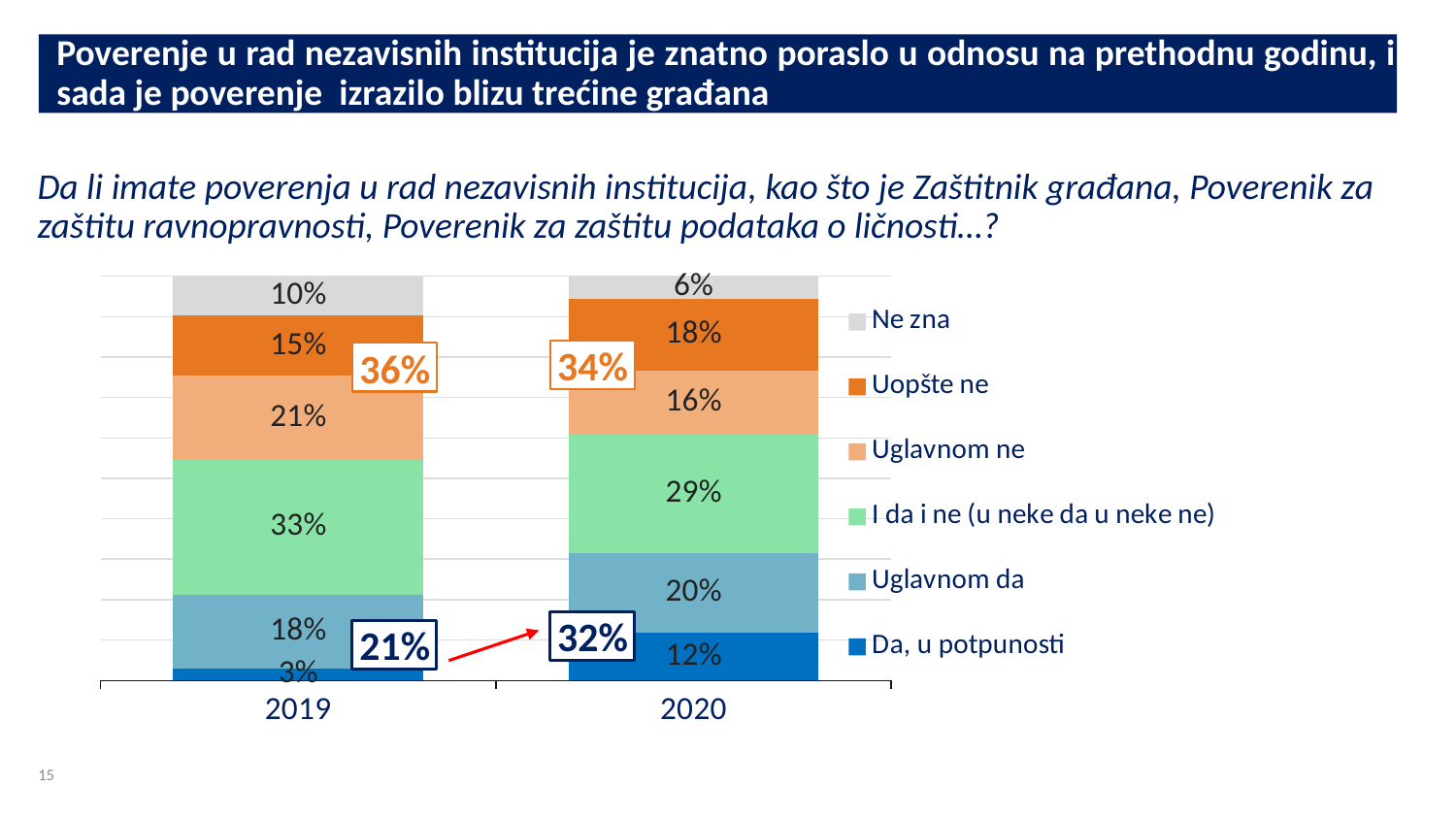
How many years (categories) are shown on the x axis? 2 What is the value for "Ne zna" in 2020? 6% What is the difference between the "Uglavnom da" values for 2020 and 2019? 2% What is the value for "Da, u potpunosti" in 2020? 12% What is the value for "Uglavnom ne" in 2019? 21% What combined percentage is annotated for the two positive answers ("Da, u potpunosti" and "Uglavnom da") in 2020? 32% Which series has the largest value in the 2020 bar? I da i ne (u neke da u neke ne) Which is larger: "Uopšte ne" in 2019 or "Uopšte ne" in 2020? 2020 What kind of chart is shown on the slide? stacked bar chart How many series does the legend list? 6 What is the value for "I da i ne (u neke da u neke ne)" in 2019? 33% Which series has the smallest value in the 2019 bar? Da, u potpunosti